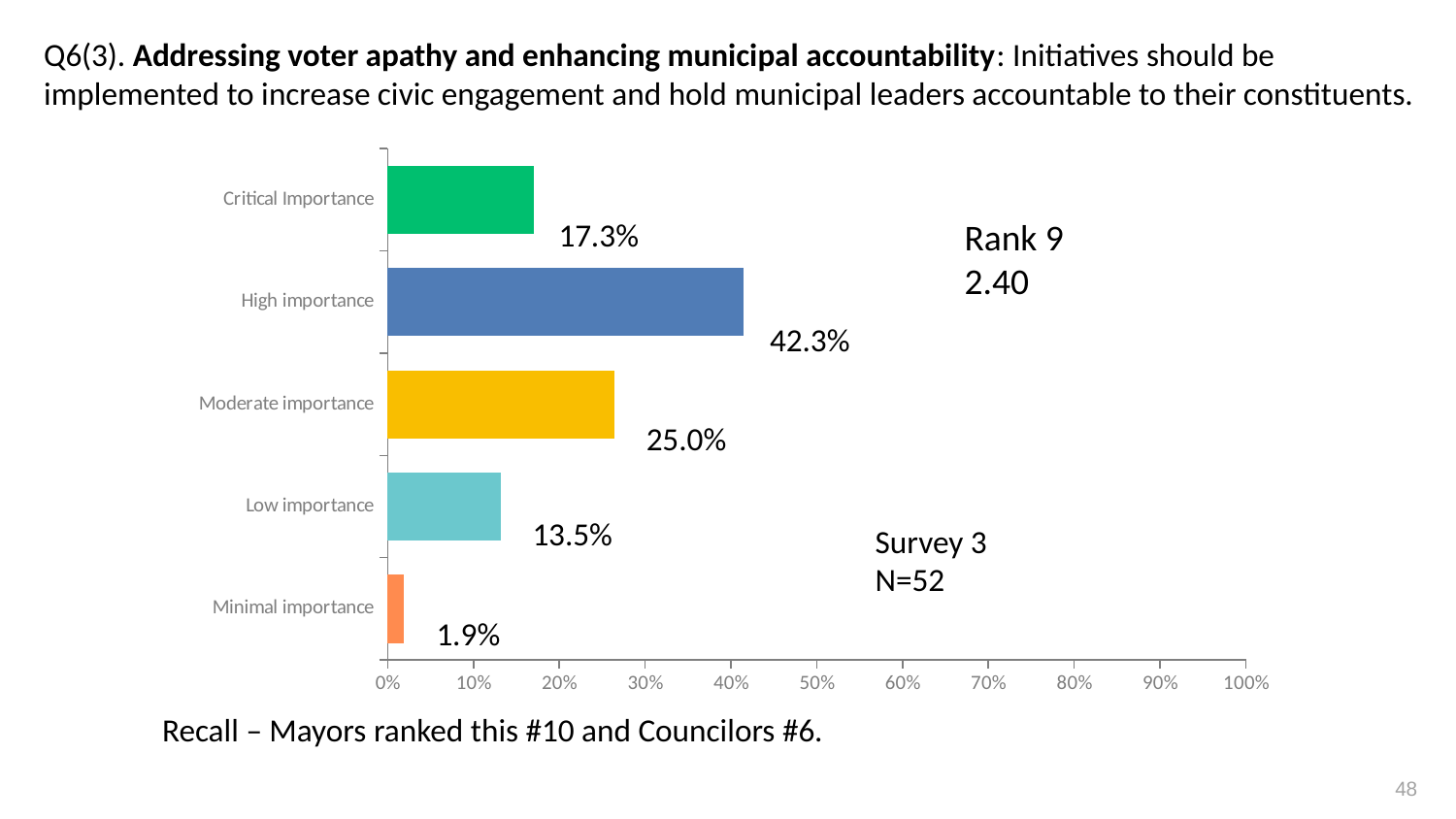
What percentage is shown for Minimal importance? 1.9% What is the difference between the High importance and Moderate importance percentages? 17.3% Which importance category has the lowest percentage? Minimal importance What is the difference between the Critical Importance and Low importance percentages? 3.8% How many importance categories are shown in the chart? 5 Which importance category has the highest percentage? High importance What percentage of respondents rated this initiative as High importance? 42.3% What is the value shown for Critical Importance? 17.3% Is the value for High importance greater or less than 40%? greater What kind of chart is shown on the slide? Bar chart Which is larger, the value for Critical Importance or the value for Low importance? Critical Importance What is the sample size (N) shown next to the chart? N=52